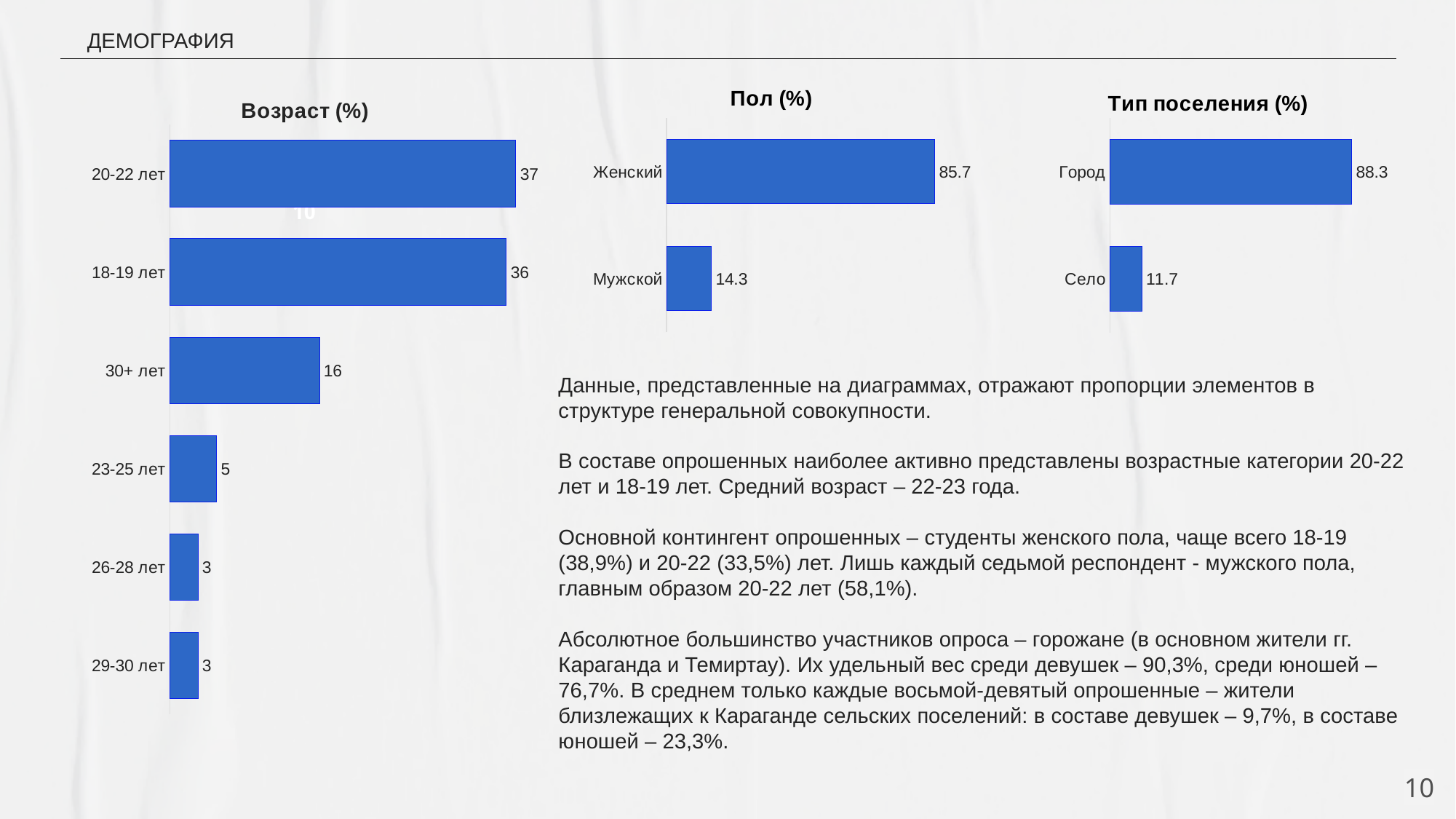
In the chart titled "Возраст (%)", which is larger: the value for 30+ лет or the value for 23-25 лет? 30+ лет In the chart titled "Пол (%)", what is the difference between the values for Женский and Мужской? 71.4 In the chart titled "Пол (%)", what is the value for Мужской? 14.3 In the chart titled "Возраст (%)", what is the difference between the values for 18-19 лет and 23-25 лет? 31 In the chart titled "Возраст (%)", how many categories are shown? 6 In the chart titled "Возраст (%)", what is the value for 20-22 лет? 37 What type of chart is the chart titled "Тип поселения (%)"? Bar chart In the chart titled "Тип поселения (%)", what is the value for Город? 88.3 In the chart titled "Тип поселения (%)", what is the difference between the values for Город and Село? 76.6 In the chart titled "Возраст (%)", what is the value for 30+ лет? 16 In the chart titled "Возраст (%)", which category has the highest value? 20-22 лет In the chart titled "Пол (%)", which category has the lowest value? Мужской